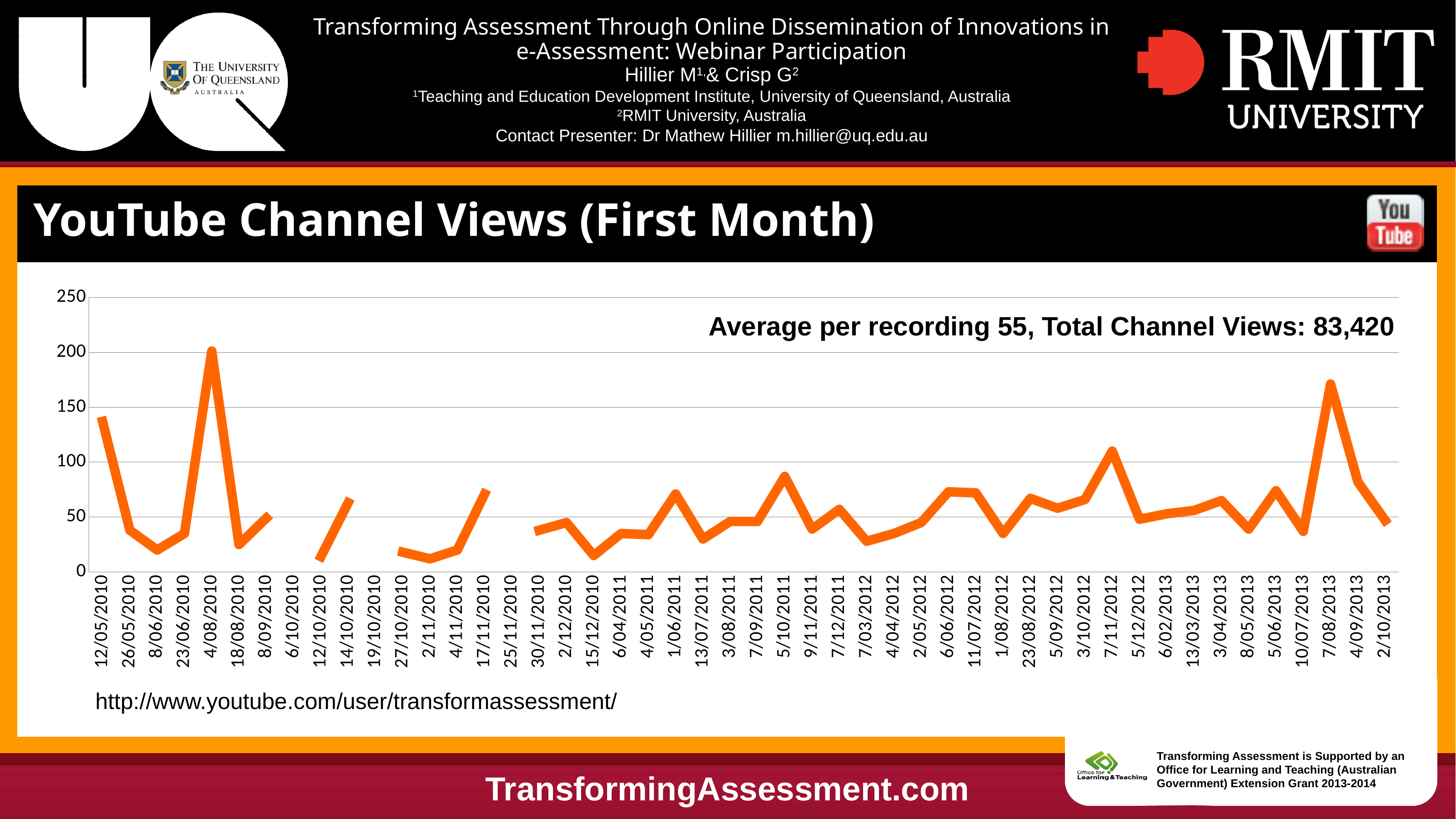
Which has more views, 12/05/2010 or 26/05/2010? 12/05/2010 Is the value for 4/08/2010 greater or less than 150? greater Is the value for 7/08/2013 greater or less than 150? greater According to the annotation on the chart, what is the average number of views per recording? 55 Is the value for 5/10/2011 greater or less than 100? less What kind of chart is shown on the slide? line chart Which has more views, 4/08/2010 or 7/08/2013? 4/08/2010 How many dates are listed along the x axis? 48 What is the title of the chart? YouTube Channel Views (First Month) Which date has the highest number of channel views? 4/08/2010